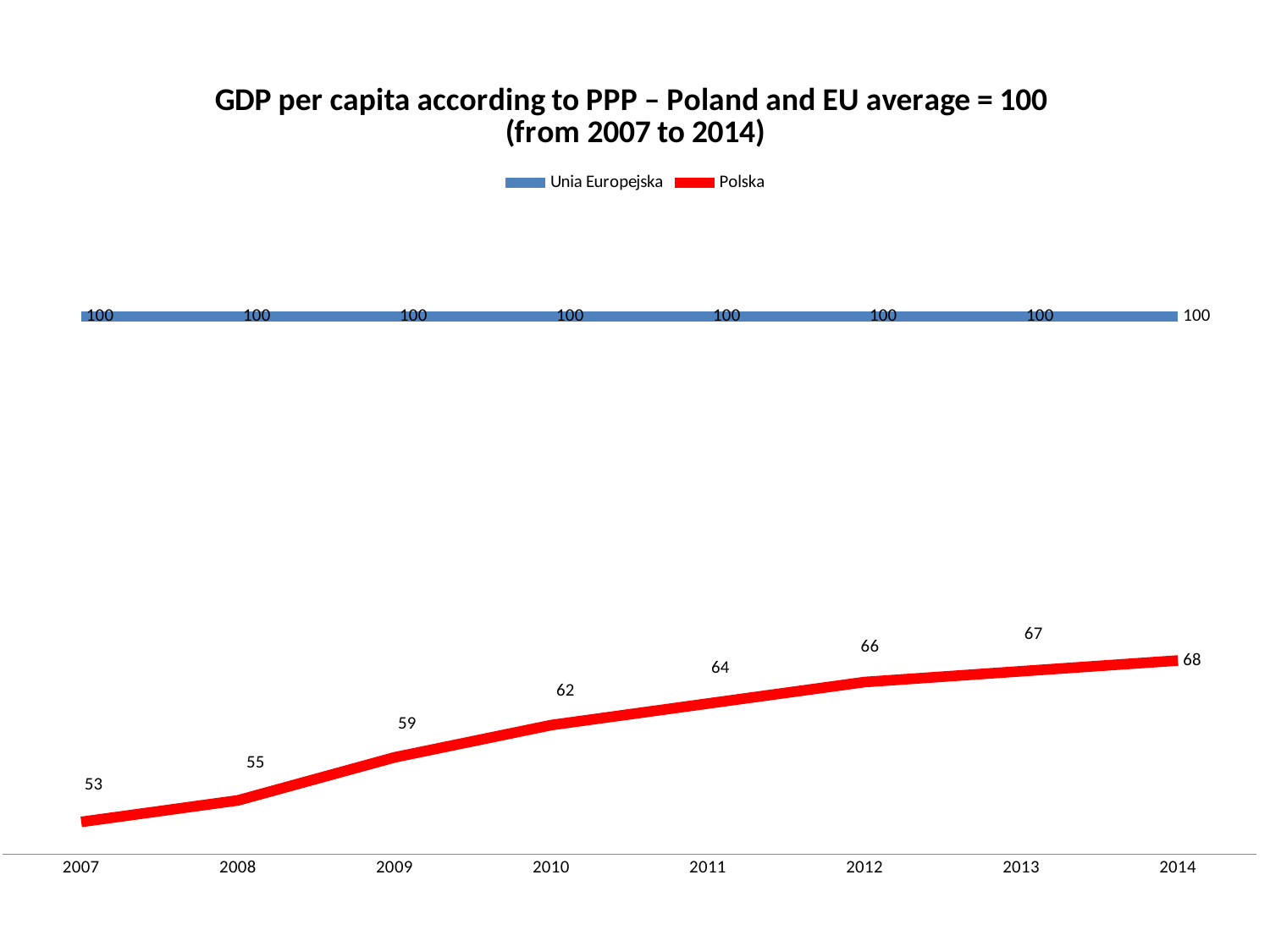
Does the Polska series rise or fall from 2007 to 2014? rise What is the value for Unia Europejska in 2011? 100 What is the value for Polska in 2014? 68 In which year is the Polska value highest? 2014 What is the value for Polska in 2007? 53 What is the difference between the Unia Europejska and Polska values in 2012? 34 How many years are shown on the x axis? 8 In which year is the Polska value lowest? 2007 What is the difference between the Polska values in 2014 and 2007? 15 How many series does the legend list? 2 What is the value for Polska in 2010? 62 Which is larger, the Polska value in 2009 or in 2008? 2009